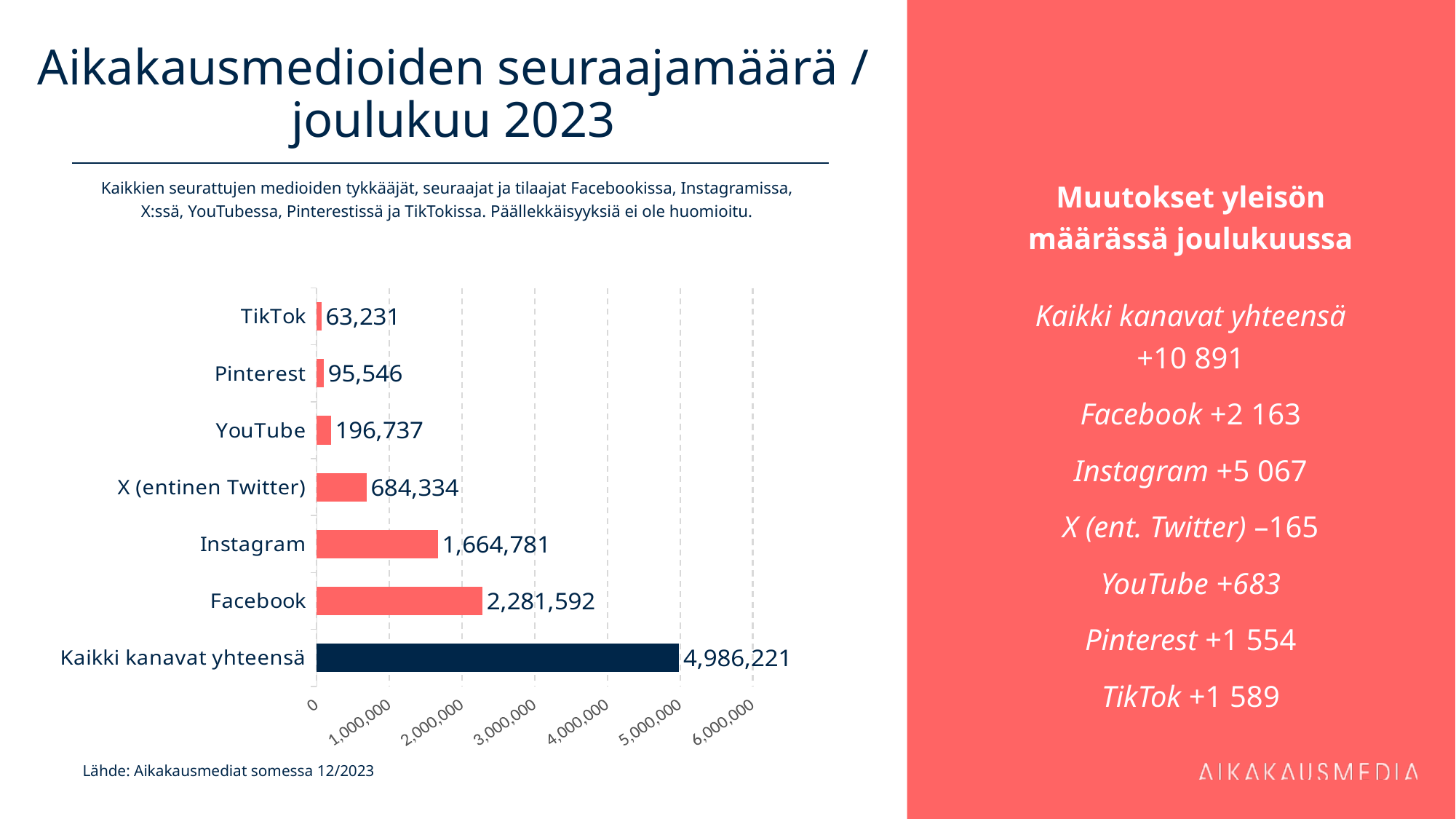
What is the value for X (entinen Twitter)? 684,334 Which is larger, the value for YouTube or the value for Pinterest? YouTube What is the value for Facebook? 2,281,592 What is the value for Instagram? 1,664,781 What is the difference between the values for Facebook and Instagram? 616,811 How many categories are shown in the chart? 7 Which category has the lowest value? TikTok Which individual channel (excluding the total bar) has the highest value? Facebook What kind of chart is shown on the slide? bar chart Is the value for Kaikki kanavat yhteensä greater or less than 4,000,000? greater What is the source cited below the chart? Aikakausmediat somessa 12/2023 What is the value for TikTok? 63,231